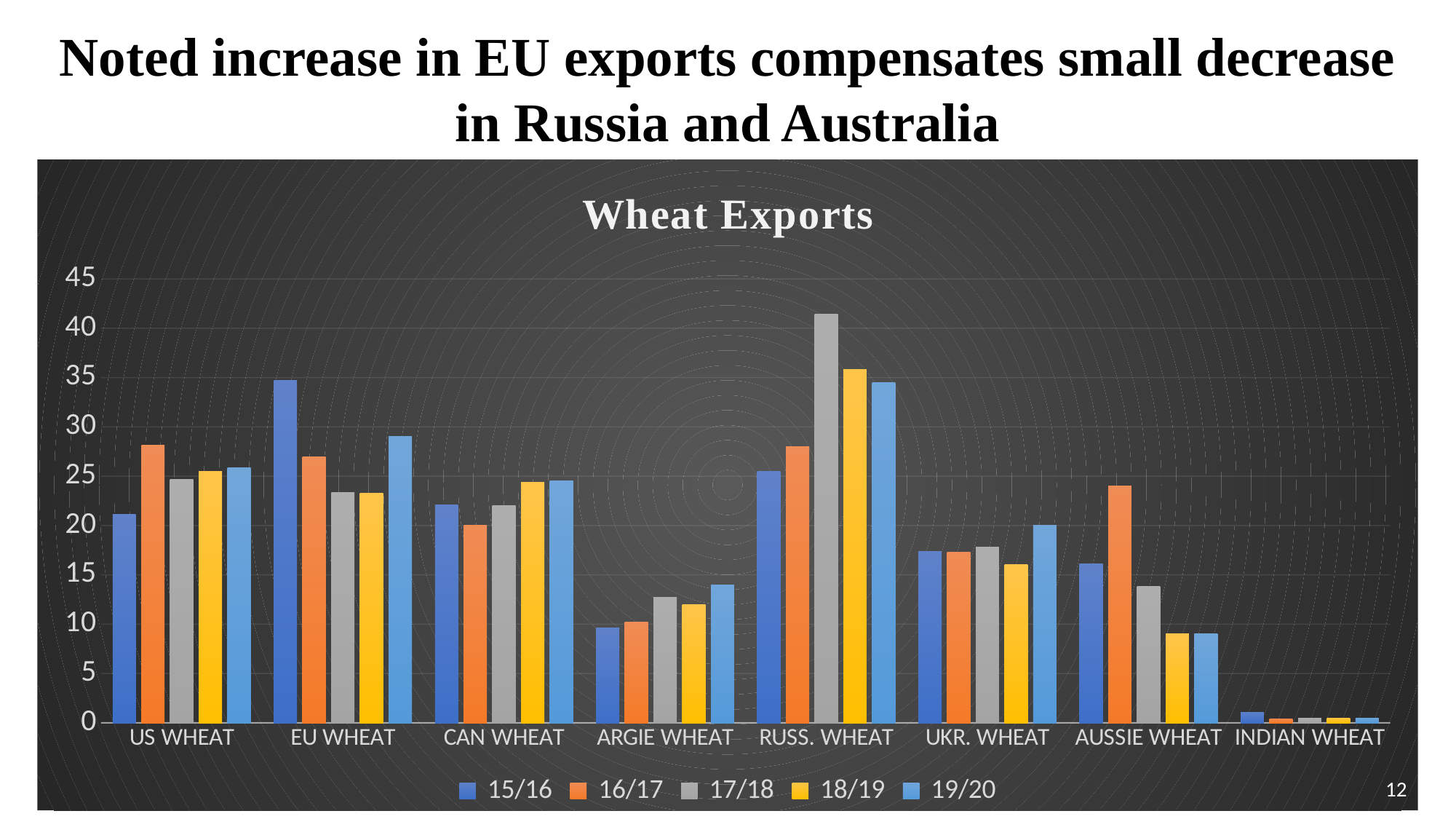
Which category and series has the tallest bar in the chart? RUSS. WHEAT, 17/18 How many series does the legend list? 5 Do the AUSSIE WHEAT values rise or fall from 16/17 to 19/20? fall What is the title of the chart? Wheat Exports For US WHEAT, which is larger: the 15/16 value or the 16/17 value? 16/17 Which category has the lowest wheat exports across all seasons? INDIAN WHEAT For AUSSIE WHEAT, which is larger: the 16/17 value or the 17/18 value? 16/17 Is the 17/18 value for RUSS. WHEAT greater or less than 40? greater What kind of chart is shown on the slide? bar chart Is the 15/16 value for EU WHEAT greater or less than 30? greater How many wheat export categories are shown on the x axis? 8